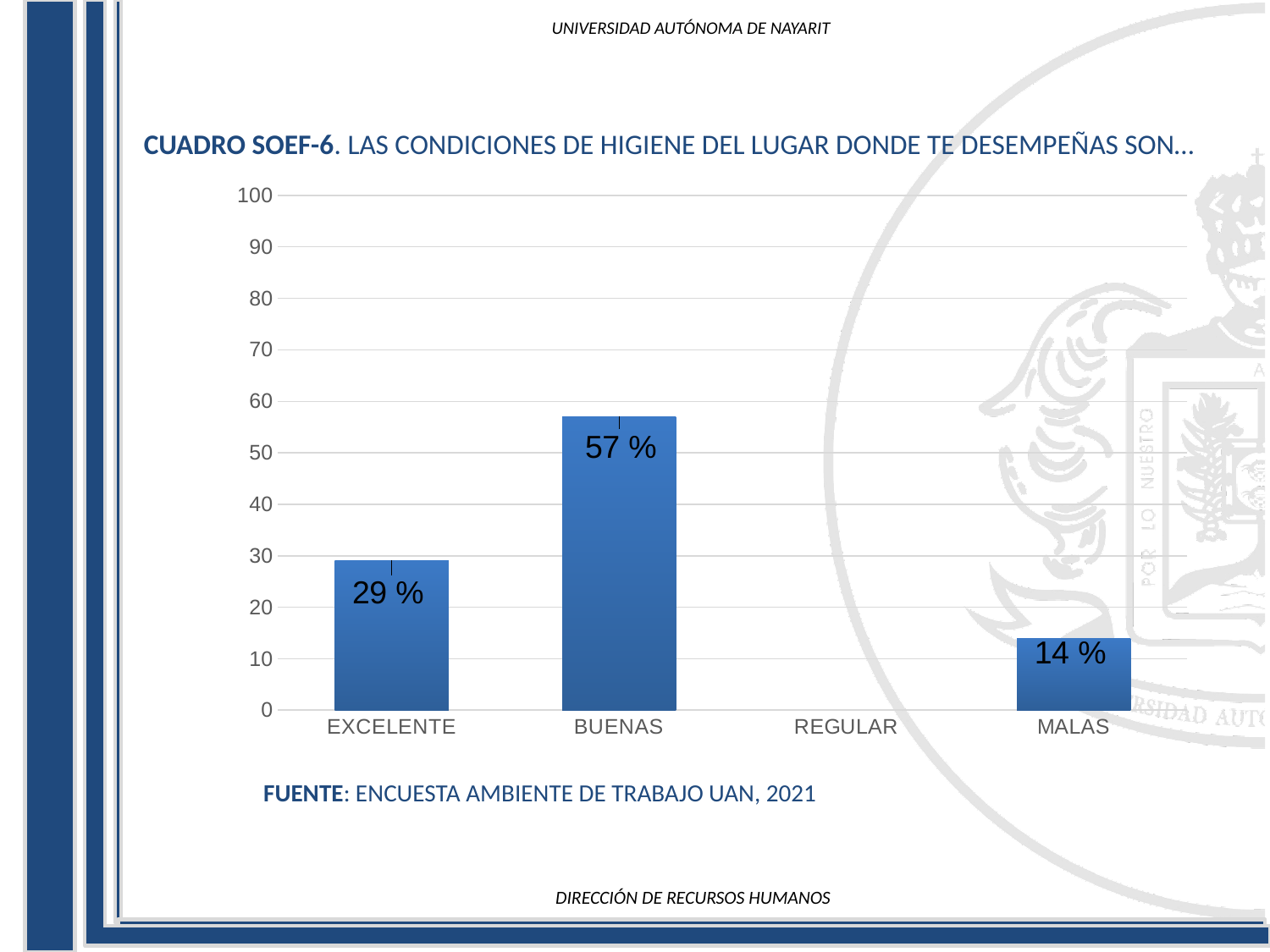
Which is larger, the value for EXCELENTE or the value for MALAS? EXCELENTE What is the difference between the values for EXCELENTE and MALAS? 15 % What is the value shown for BUENAS? 57 % How many categories are shown on the x axis? 4 Which category has the shortest visible bar? MALAS Is the value for BUENAS greater or less than 50? greater What is the value shown for MALAS? 14 % Which category has the highest value? BUENAS What is the value shown for EXCELENTE? 29 % What source is cited below the chart? ENCUESTA AMBIENTE DE TRABAJO UAN, 2021 What kind of chart is shown on the slide? bar chart What is the difference between the values for BUENAS and EXCELENTE? 28 %